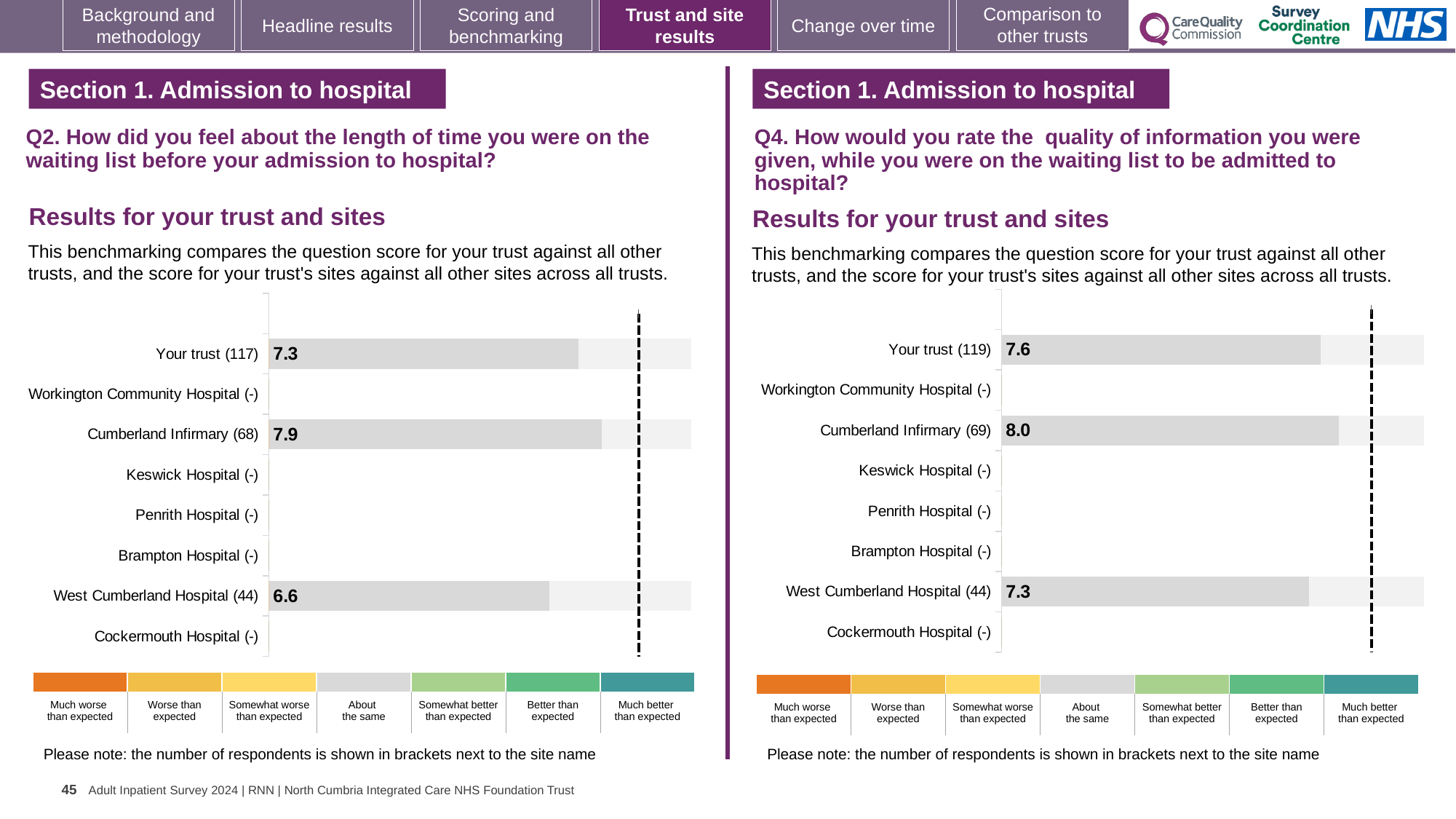
What kind of chart is used on the Q4 chart (right)? Bar chart In the Q4 chart (right), is the score for Cumberland Infirmary or Your trust larger? Cumberland Infirmary In the Q2 chart (left), what is the score for Your trust? 7.3 How many sites (including Your trust) are listed on the Q2 chart (left)? 8 In the Q2 chart (left), what is the score for Cumberland Infirmary? 7.9 In the Q4 chart (right), what is the score for Your trust? 7.6 In the Q4 chart (right), what is the score for Cumberland Infirmary? 8.0 In the Q2 chart (left), what is the score for West Cumberland Hospital? 6.6 In the Q4 chart (right), what is the score for West Cumberland Hospital? 7.3 In the Q2 chart (left), what is the difference between the scores for Cumberland Infirmary and West Cumberland Hospital? 1.3 In the Q4 chart (right), which site has the lowest score among those with a value shown? West Cumberland Hospital In the Q2 chart (left), which site has the highest score? Cumberland Infirmary